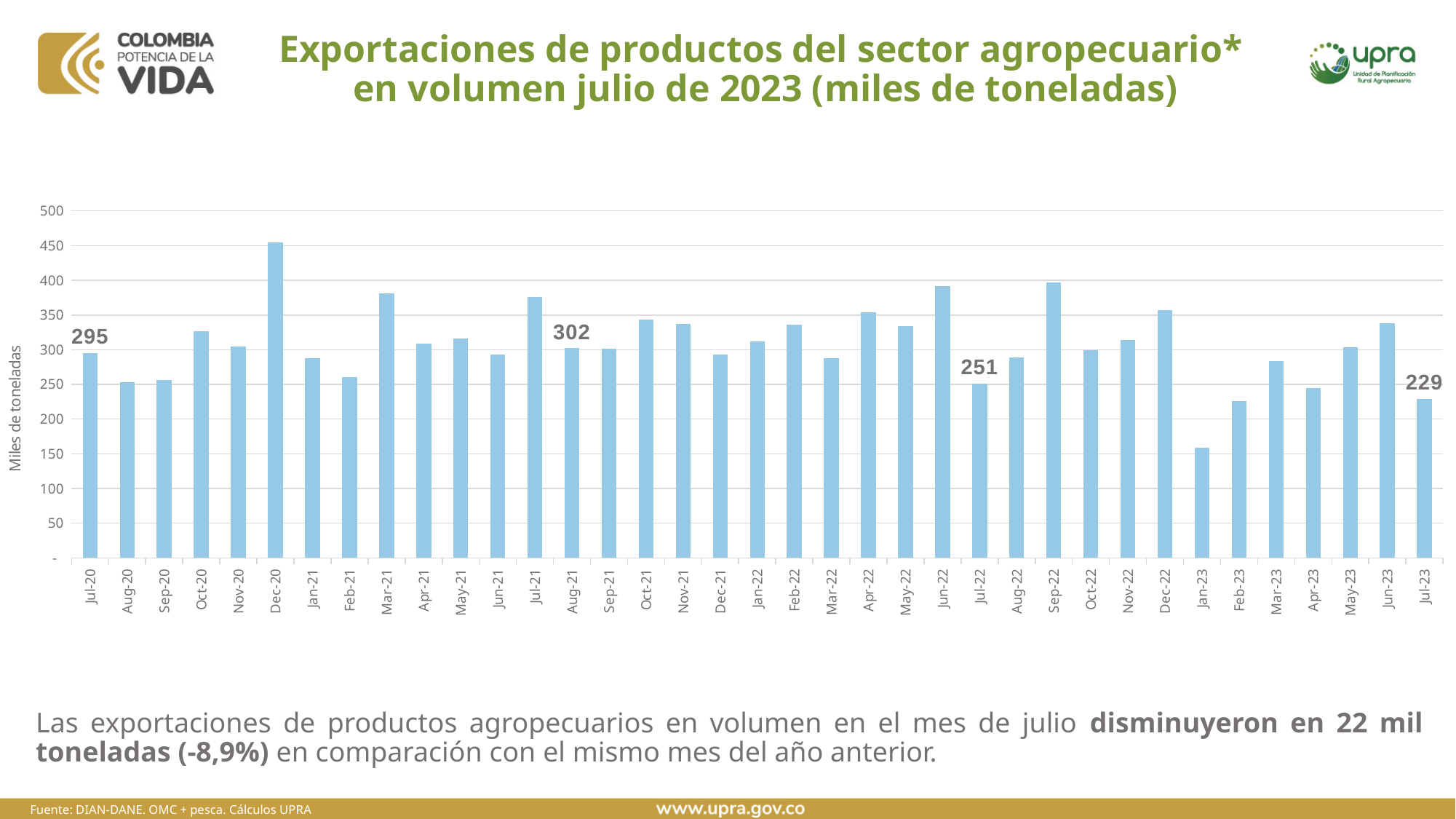
What is the difference between the values for Jul-22 and Jul-23? 22 Which month has the highest bar? Dec-20 Which is larger, the value for Jul-20 or the value for Jul-21? Jul-21 Which month has the lowest bar? Jan-23 What is the value for Jul-22? 251 What is the value for Jul-23? 229 What is the value for Jul-20? 295 What kind of chart is shown on the slide? bar chart Is the value for Dec-20 greater or less than 400? greater How many monthly bars are plotted in the chart? 37 Is the value for Jan-23 greater or less than 200? less